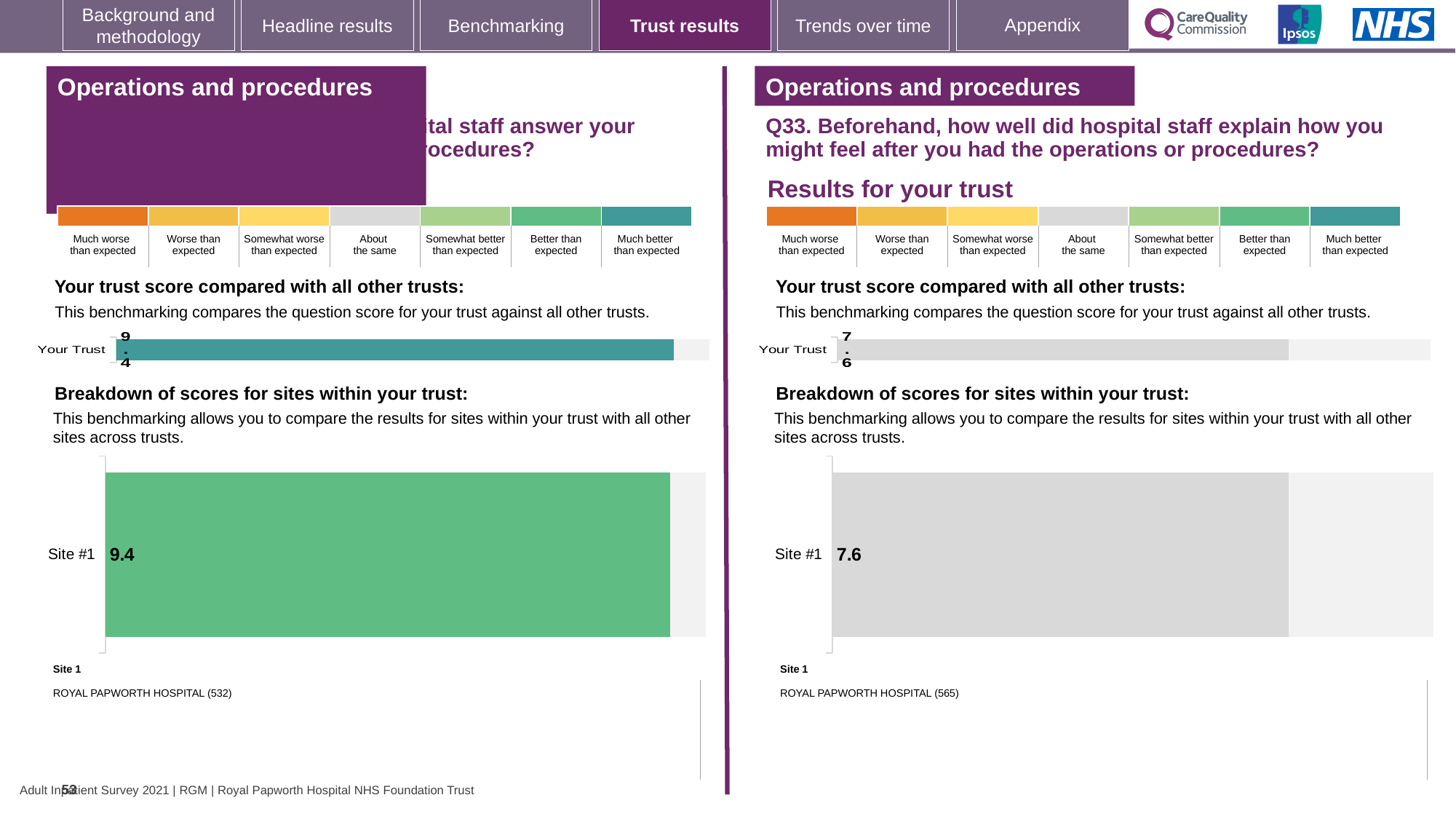
What kind of chart is used to show the Site #1 score on the right-hand Q33 breakdown? Bar chart On the left-hand 'Your trust score compared with all other trusts' chart, what is the score shown for Your Trust? 9.4 On the left-hand 'Breakdown of scores for sites within your trust' chart, what is the score for Site #1? 9.4 On the right-hand 'Breakdown of scores for sites within your trust' chart for Q33, what is the score for Site #1? 7.6 How many sites are shown in the right-hand 'Breakdown of scores for sites within your trust' chart for Q33? 1 How many sites are shown in the left-hand 'Breakdown of scores for sites within your trust' chart? 1 On the right-hand chart for Q33, what is the score shown for Your Trust? 7.6 Which is larger: the Your Trust score on the left-hand chart or the Your Trust score on the right-hand Q33 chart? The left-hand chart (9.4) Which hospital is listed as Site 1 beneath the right-hand Q33 breakdown chart? ROYAL PAPWORTH HOSPITAL (565) What colour is the Site #1 bar in the left-hand breakdown chart? Green What is the difference between the Site #1 score on the left-hand chart and the Site #1 score on the right-hand Q33 chart? 1.8 Which of the two Site #1 scores on the slide is lower, the left-hand chart or the right-hand Q33 chart? The right-hand Q33 chart (7.6)